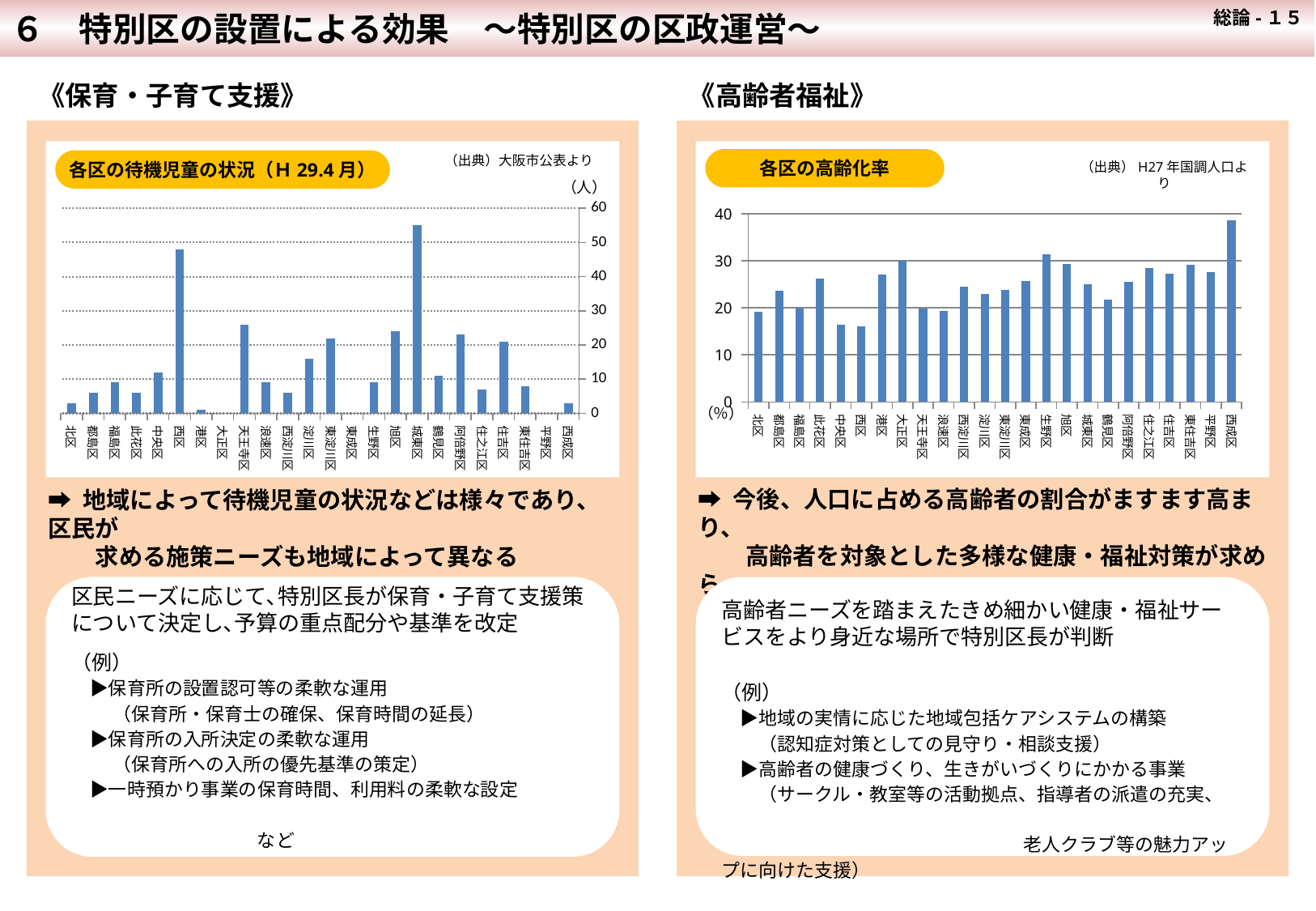
In the left chart 各区の待機児童の状況（H29.4月）, which ward has the highest value? 城東区 What is the source noted for the right chart 各区の高齢化率? H27年国調人口より In the left chart 各区の待機児童の状況（H29.4月）, which has the larger value, 城東区 or 西区? 城東区 In the left chart 各区の待機児童の状況（H29.4月）, is the value for 天王寺区 greater or less than 20? greater In the right chart 各区の高齢化率, is the value for 中央区 greater or less than 20? less What unit is shown on the y axis of the left chart 各区の待機児童の状況（H29.4月）? （人） In the left chart 各区の待機児童の状況（H29.4月）, is the value for 北区 greater or less than 10? less How many wards are shown on the x axis of the left chart 各区の待機児童の状況（H29.4月）? 24 In the right chart 各区の高齢化率, which has the larger value, 此花区 or 中央区? 此花区 In the right chart 各区の高齢化率, which ward has the highest value? 西成区 What kind of chart is the left chart titled 各区の待機児童の状況（H29.4月）? bar chart